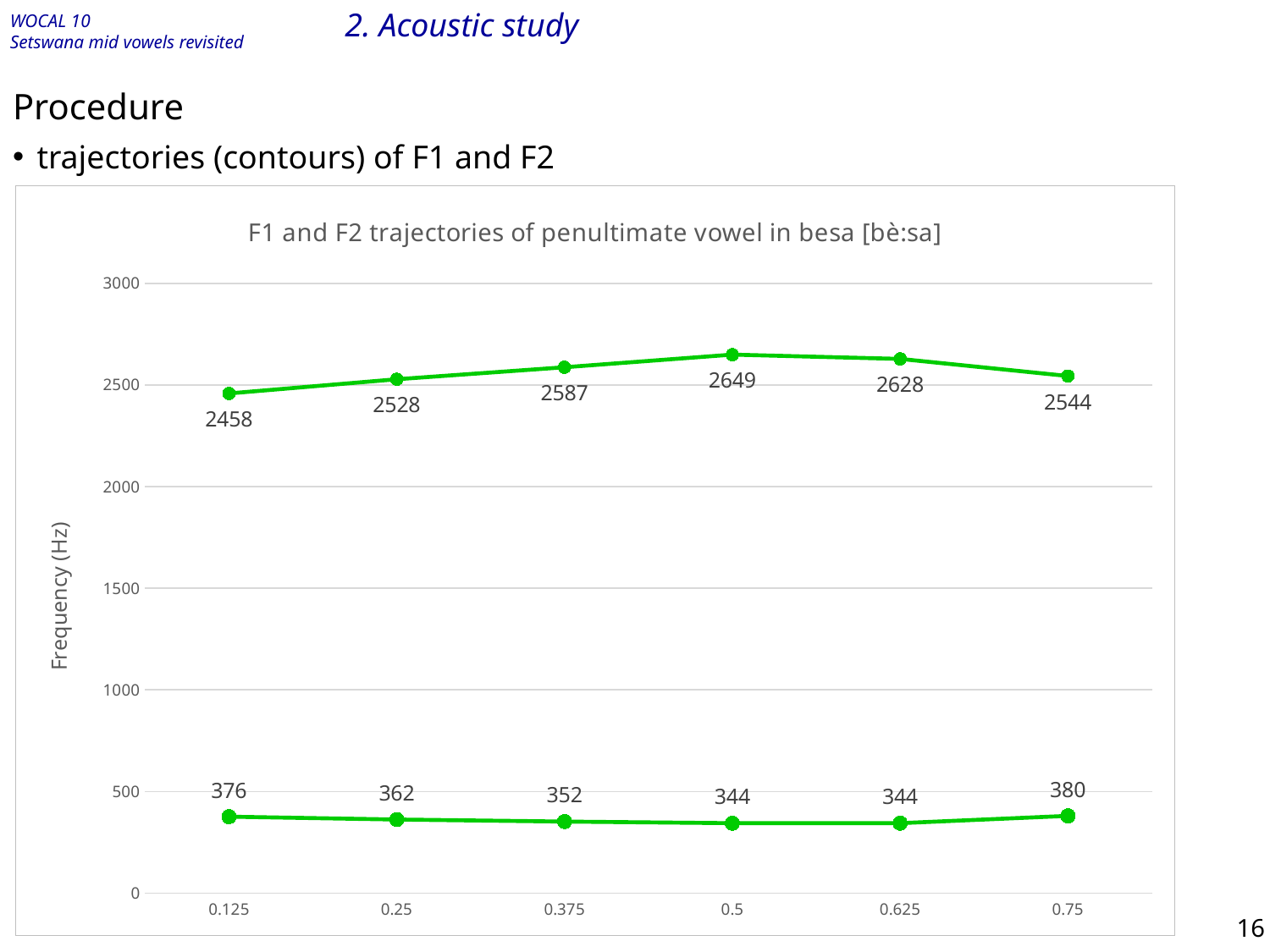
What is the value of the upper line at 0.5? 2649 What is the difference between the upper line's values at 0.5 and 0.125? 191 At which x-axis point does the upper line have its lowest value? 0.125 What is the value of the lower line at 0.125? 376 At which x-axis point does the upper line reach its highest value? 0.5 At which x-axis point does the lower line reach its highest value? 0.75 How many x-axis points are plotted on each line? 6 Which is larger for the lower line: the value at 0.25 or the value at 0.375? 0.25 What is the chart title? F1 and F2 trajectories of penultimate vowel in besa [bè:sa] What type of chart is shown on the slide? line chart What is the difference between the lower line's values at 0.75 and 0.5? 36 What is the value of the upper line at 0.75? 2544